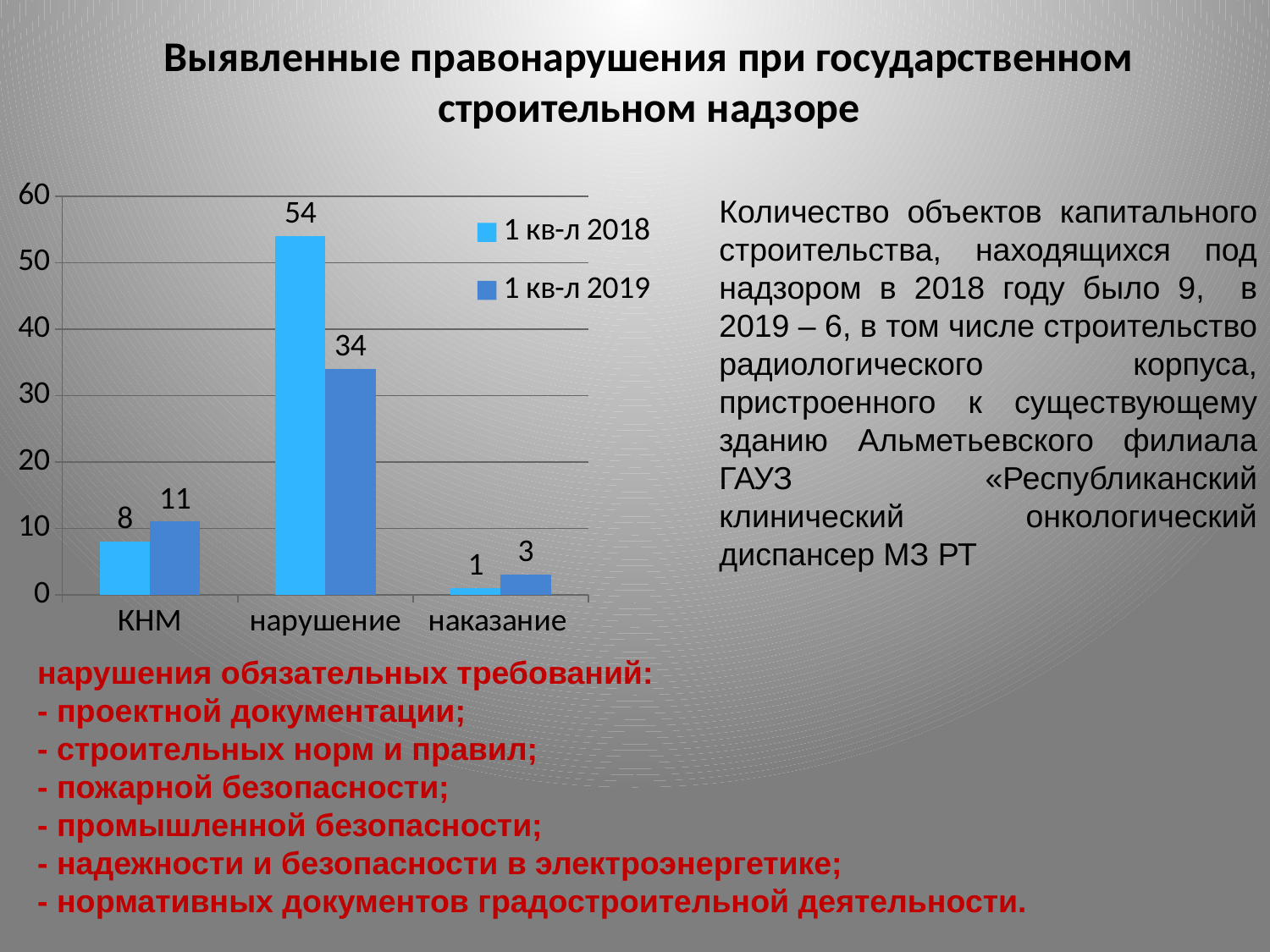
What is the value for нарушение in the 1 кв-л 2019 series? 34 How many categories are shown on the x axis? 3 What kind of chart is shown on the slide? bar chart What is the value for наказание in the 1 кв-л 2018 series? 1 Which category has the lowest value in the 1 кв-л 2019 series? наказание Which is larger for КНМ: the 1 кв-л 2018 value or the 1 кв-л 2019 value? 1 кв-л 2019 What are the two legend entries of the chart? 1 кв-л 2018 and 1 кв-л 2019 What is the value for КНМ in the 1 кв-л 2018 series? 8 What is the difference between the 1 кв-л 2018 and 1 кв-л 2019 values for нарушение? 20 How many series does the legend list? 2 Which category has the highest value in the 1 кв-л 2018 series? нарушение Is the value for нарушение in the 1 кв-л 2018 series greater or less than 50? greater